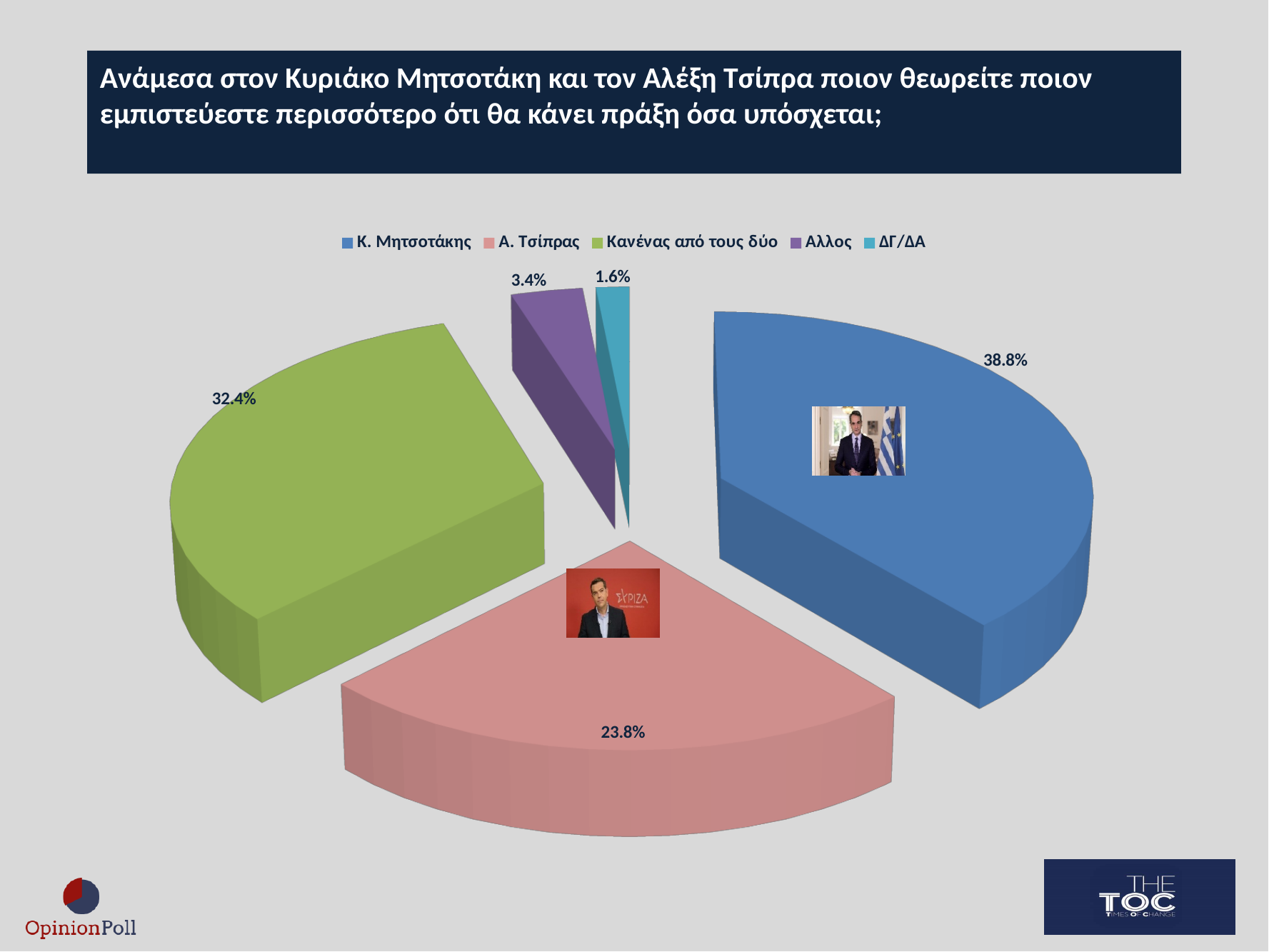
Which category has the largest share of the pie? Κ. Μητσοτάκης Which is larger, the share for Κανένας από τους δύο or the share for Α. Τσίπρας? Κανένας από τους δύο What colour is the slice for Κανένας από τους δύο? Green What is the difference in percentage points between Κ. Μητσοτάκης and Α. Τσίπρας? 15 percentage points What percentage of respondents answered Κανένας από τους δύο? 32.4% What percentage of respondents answered ΔΓ/ΔΑ? 1.6% What percentage of respondents chose Κ. Μητσοτάκης? 38.8% Which category has the smallest share of the pie? ΔΓ/ΔΑ What percentage of respondents answered Άλλος? 3.4% What percentage of respondents chose Α. Τσίπρας? 23.8% How many categories does the pie chart show? 5 What kind of chart is shown on the slide? Pie chart